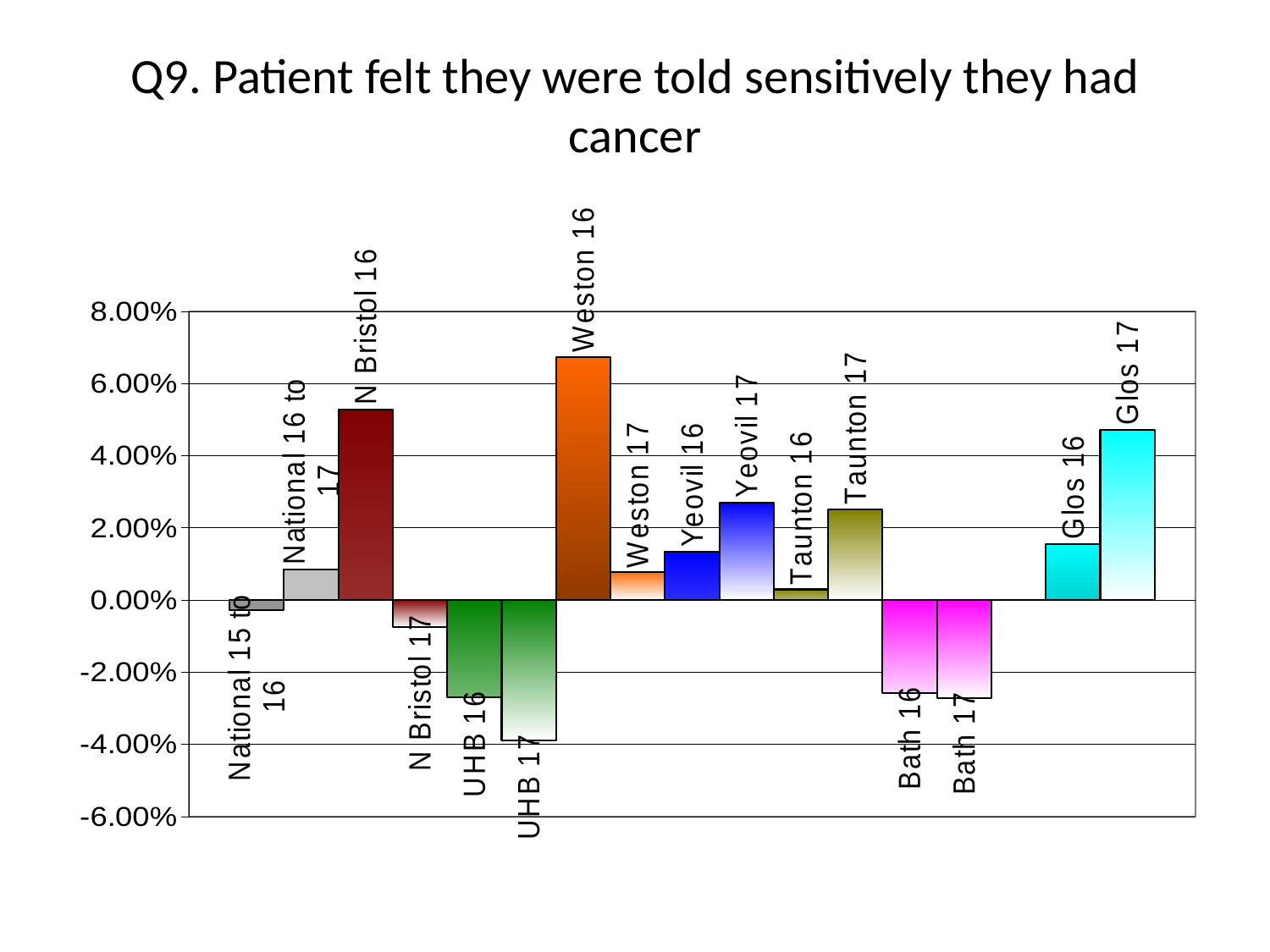
Is the value for Weston 16 greater or less than 6.00%? greater What is the title of the chart? Q9. Patient felt they were told sensitively they had cancer Is the value for Bath 16 greater or less than 0.00%? less How many bars (categories) are plotted in the chart? 16 Is the value for N Bristol 16 greater or less than 4.00%? greater Which is larger, the value for Glos 17 or the value for Glos 16? Glos 17 Which category has the lowest value? UHB 17 Which category has the highest value? Weston 16 Which is larger, the value for Yeovil 17 or the value for Yeovil 16? Yeovil 17 What kind of chart is shown on the slide? bar chart